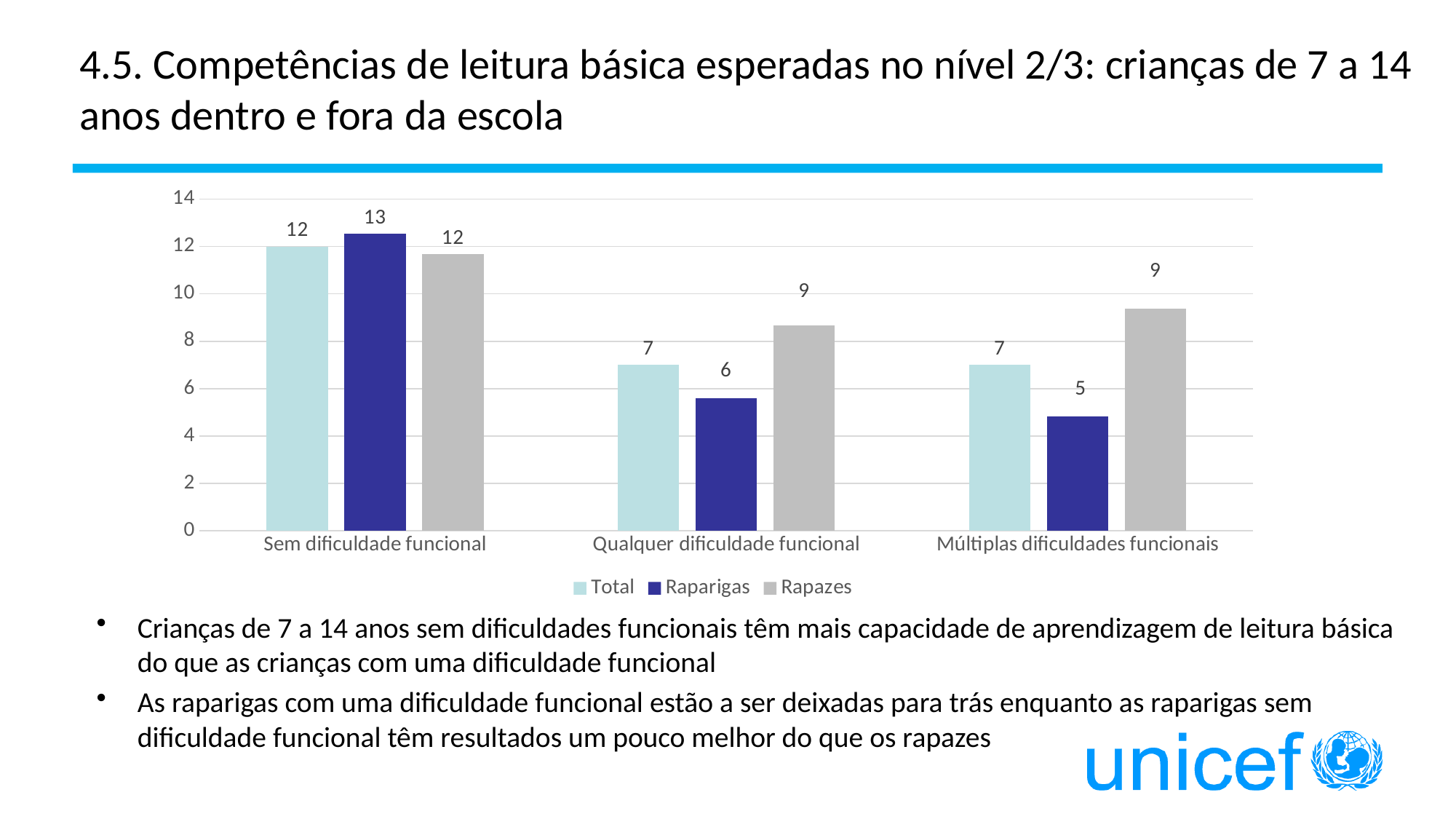
Which is larger: the Raparigas value for Sem dificuldade funcional or the Raparigas value for Qualquer dificuldade funcional? Sem dificuldade funcional What is the value for Rapazes in the Qualquer dificuldade funcional category? 9 What is the Total value for the Qualquer dificuldade funcional category? 7 How many series does the legend list? 3 What is the value for Raparigas in the Múltiplas dificuldades funcionais category? 5 What is the value for Raparigas in the Sem dificuldade funcional category? 13 Is the Rapazes value for Múltiplas dificuldades funcionais greater or less than 10? less Which series has the lowest value in the Múltiplas dificuldades funcionais category? Raparigas What is the difference between the Rapazes and Raparigas values in the Múltiplas dificuldades funcionais category? 4 How many categories are shown on the x axis? 3 Which series has the highest value in the Sem dificuldade funcional category? Raparigas What kind of chart is shown on the slide? Bar chart